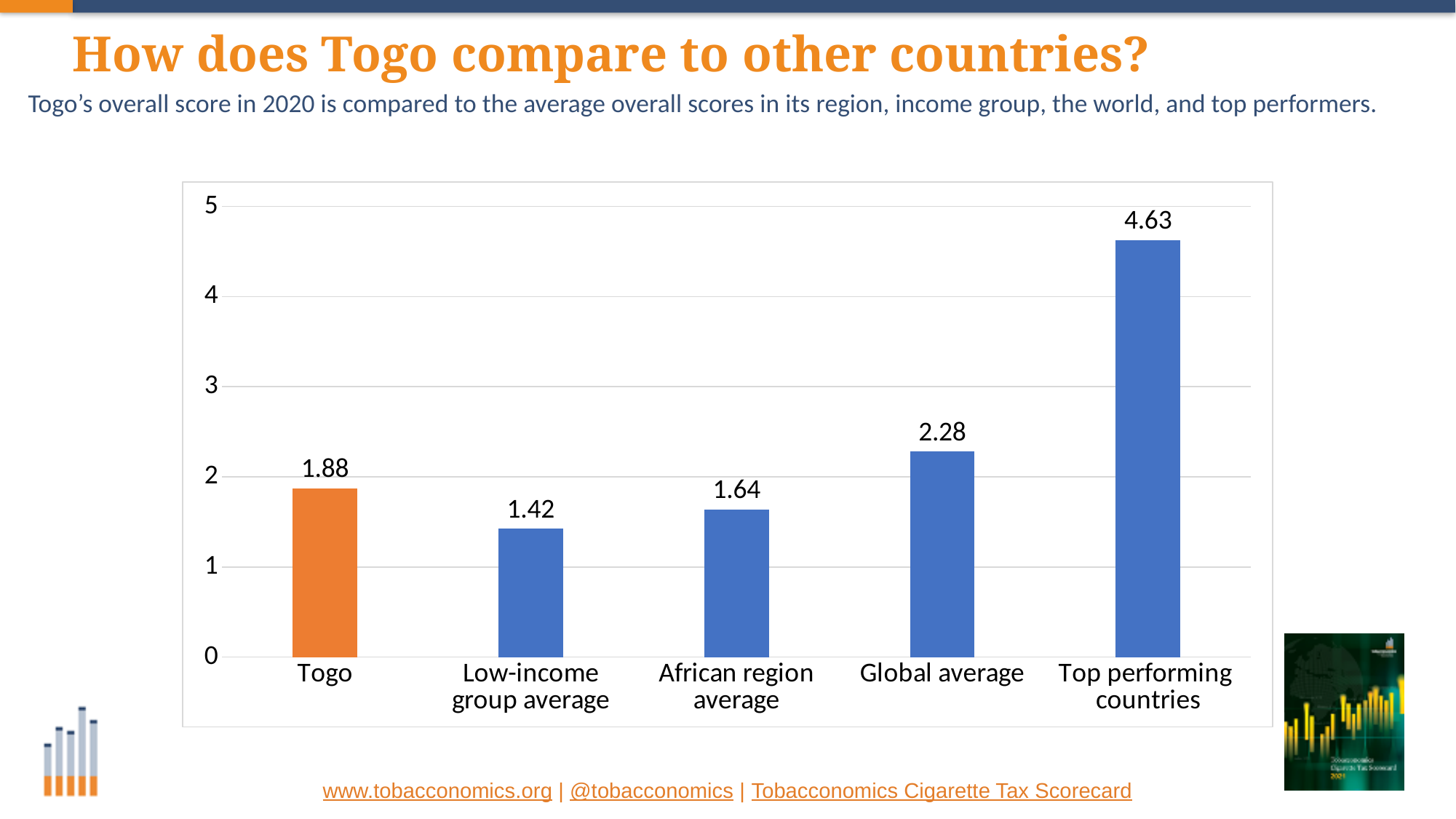
What is the difference between the Top performing countries value and Togo's value? 2.75 Which bar is coloured orange rather than blue? Togo What is the overall score shown for Togo? 1.88 Which category has the lowest value? Low-income group average What kind of chart is shown on the slide? Bar chart What is the value shown for the African region average? 1.64 What is the difference between Togo's value and the African region average? 0.24 What is the value shown for the Global average? 2.28 Which is larger, Togo's value or the Global average? Global average Which category has the highest value? Top performing countries What is the value shown for the Low-income group average? 1.42 How many categories are shown on the chart? 5